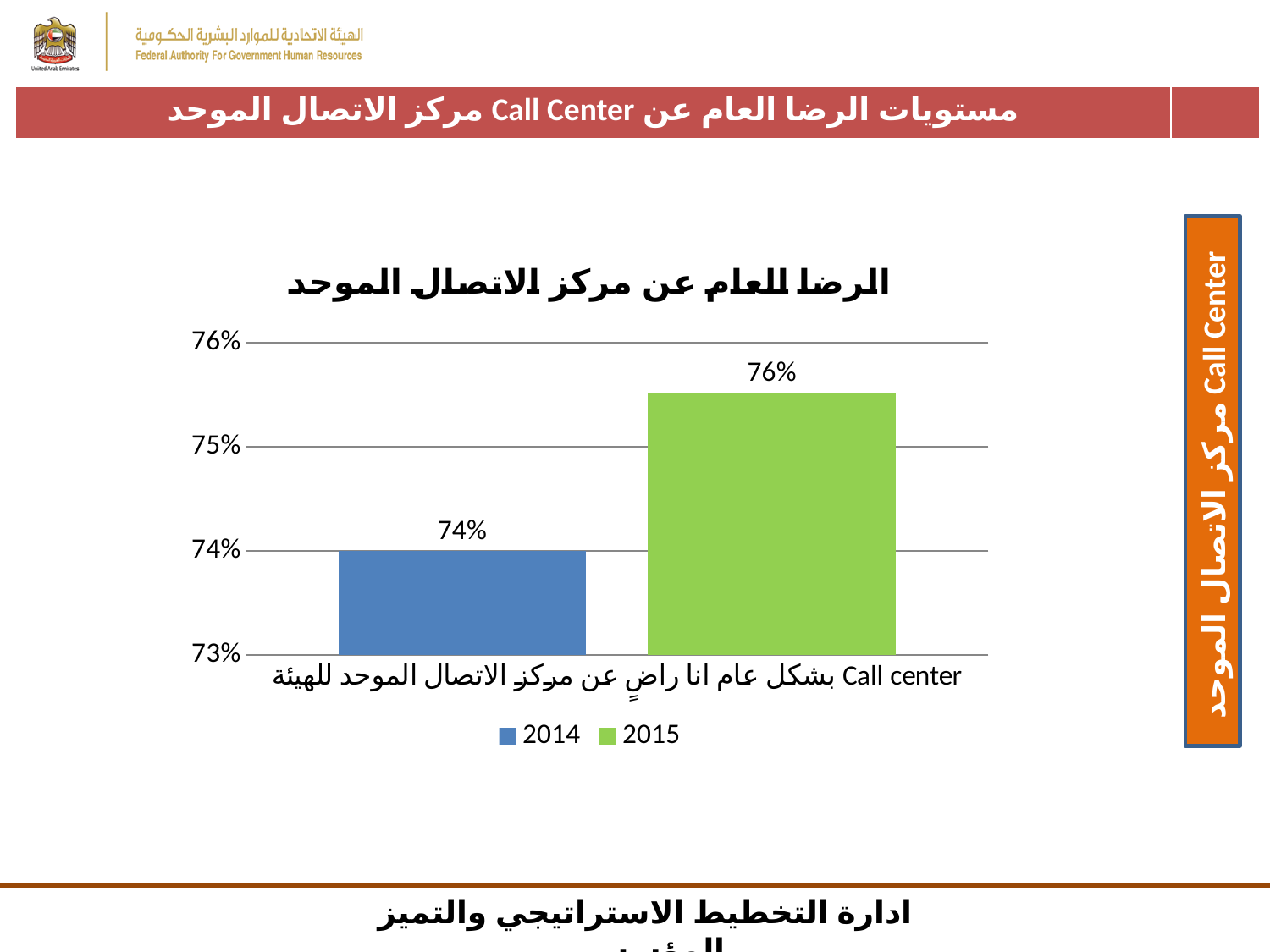
Which year has the higher satisfaction value, 2014 or 2015? 2015 Which series shows the lowest value in the chart? 2014 Which series shows the highest value in the chart? 2015 What kind of chart is shown on the slide? Bar chart Is the value for 2015 greater or less than 75%? greater What is the value for 2014 in the chart? 74% What is the difference between the 2015 value and the 2014 value? 2% What is the value for 2015 in the chart? 76% What colour is the bar for 2015? Green Did the satisfaction value rise or fall from 2014 to 2015? Rise How many series does the legend list? 2 Is the value for 2014 greater or less than 75%? less